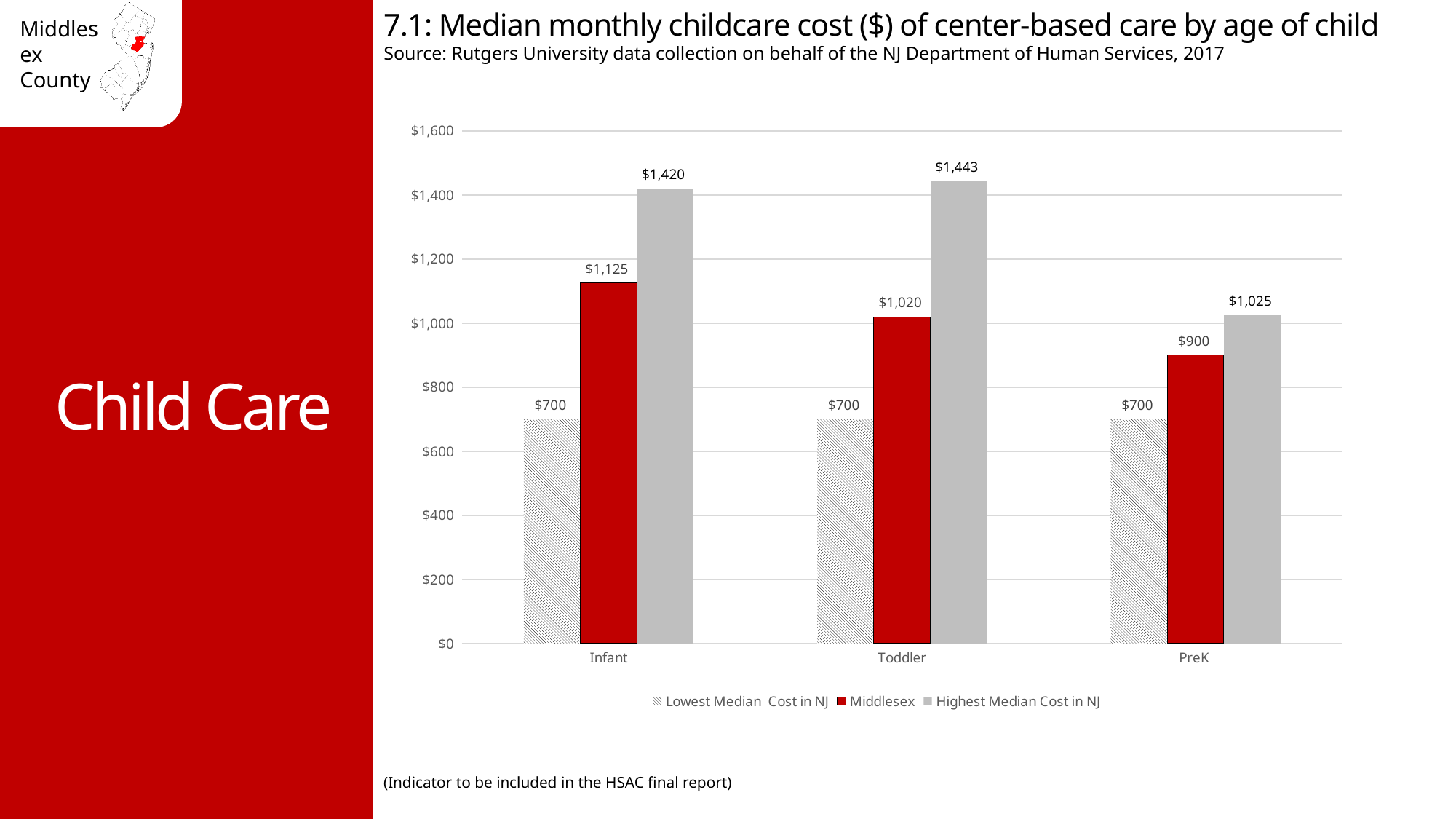
How many series does the legend list? 3 Which age group has the lowest Highest Median Cost in NJ? PreK How many age groups are shown on the x axis? 3 What is the Middlesex median monthly childcare cost for Infant care? $1,125 Which age group has the highest Middlesex median monthly cost? Infant What is the difference between the Middlesex cost for Toddler care and the Middlesex cost for PreK care? $120 What is the Lowest Median Cost in NJ for PreK care? $700 Do the Middlesex values rise or fall from Infant to PreK? Fall Which is larger: the Middlesex cost for Toddler care or the Highest Median Cost in NJ for PreK care? Highest Median Cost in NJ for PreK care What is the difference between the Highest Median Cost in NJ and the Middlesex cost for Infant care? $295 What kind of chart is shown on the slide? Bar chart What is the Highest Median Cost in NJ for Toddler care? $1,443